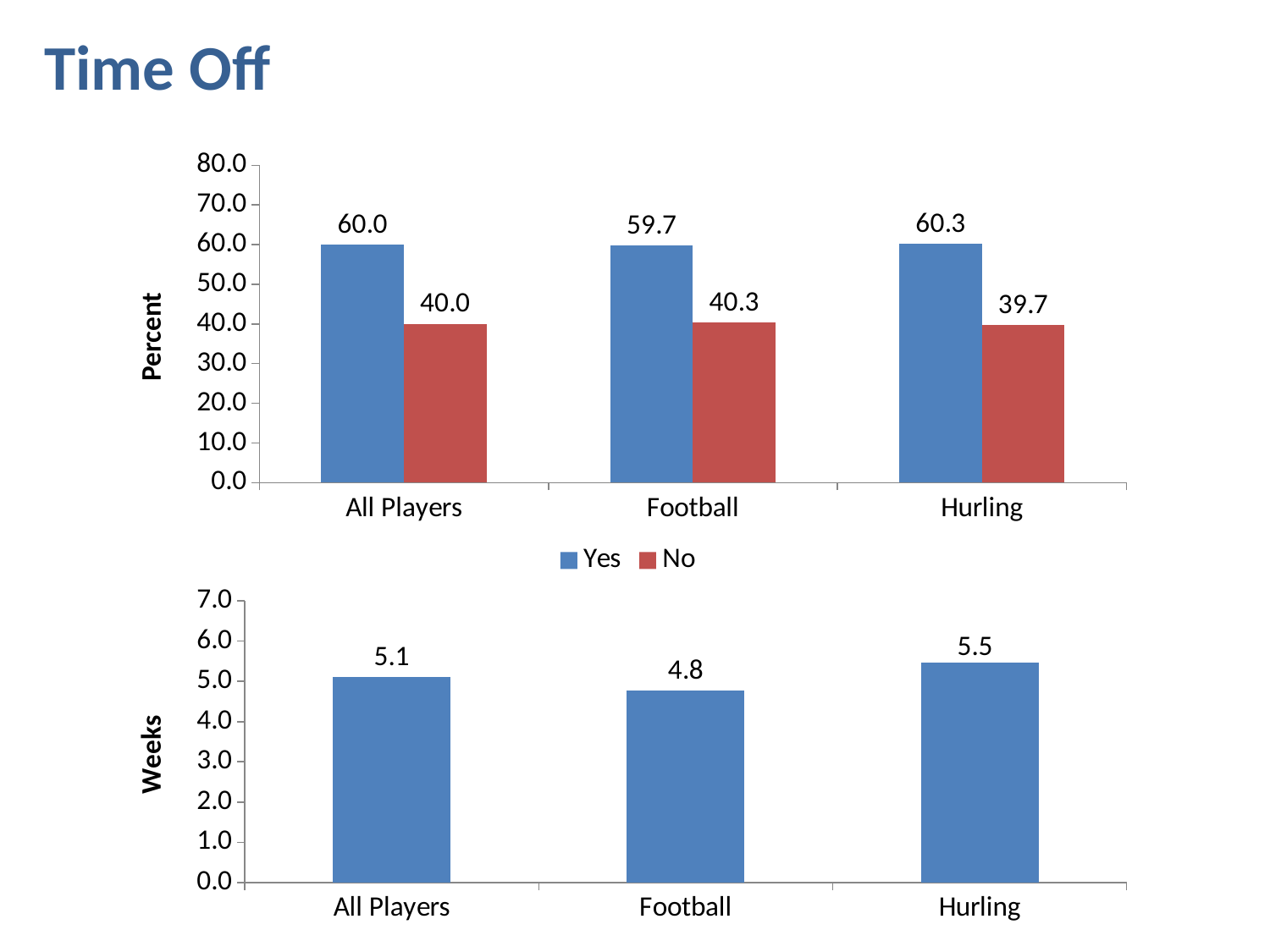
In the bottom chart (Weeks), which category has the highest value? Hurling How many series does the legend of the top chart (Percent) list? 2 In the bottom chart (Weeks), which category has the lowest value? Football In the bottom chart (Weeks), what is the difference between the values for Hurling and Football? 0.7 In the top chart (Percent), what is the value for No for All Players? 40.0 What kind of chart is the bottom chart (Weeks)? Bar chart In the top chart (Percent), which is larger for Football: Yes or No? Yes How many categories are shown on the x axis of the bottom chart (Weeks)? 3 In the bottom chart (Weeks), what is the value for Football? 4.8 In the top chart (Percent), what is the value for No for Hurling? 39.7 In the top chart (Percent), what is the value for Yes for Football? 59.7 In the top chart (Percent), what is the difference between the Yes and No values for Hurling? 20.6